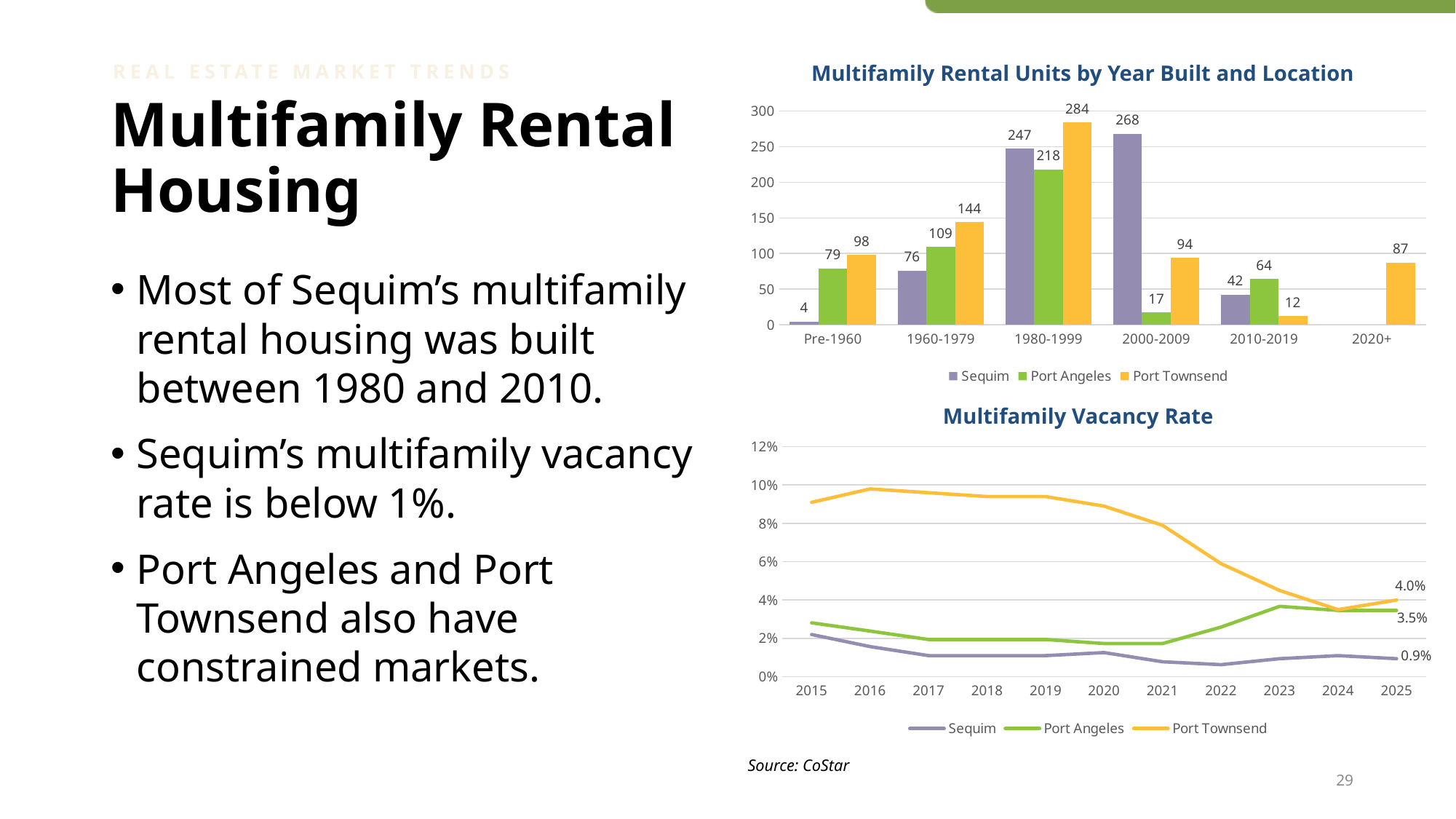
In the 'Multifamily Rental Units by Year Built and Location' chart, which period has the highest value for Sequim? 2000-2009 In the 'Multifamily Rental Units by Year Built and Location' chart, which is larger for 2010-2019: Sequim or Port Angeles? Port Angeles In the 'Multifamily Rental Units by Year Built and Location' chart, which period has the lowest value for Port Angeles? 2000-2009 In the 'Multifamily Vacancy Rate' chart, what is the Sequim vacancy rate in 2025? 0.9% In the 'Multifamily Rental Units by Year Built and Location' chart, how many Sequim units were built in 2000-2009? 268 In the 'Multifamily Rental Units by Year Built and Location' chart, how many series does the legend list? 3 In the 'Multifamily Rental Units by Year Built and Location' chart, how many Port Townsend units were built in 1980-1999? 284 In the 'Multifamily Vacancy Rate' chart, is the Port Townsend value for 2016 greater or less than 8%? greater In the 'Multifamily Rental Units by Year Built and Location' chart, how many year-built categories are shown on the x axis? 6 In the 'Multifamily Rental Units by Year Built and Location' chart, what is the difference between Port Townsend and Port Angeles units built in 1960-1979? 35 What kind of chart is 'Multifamily Rental Units by Year Built and Location'? Bar chart In the 'Multifamily Vacancy Rate' chart, does the Port Townsend vacancy rate rise or fall from 2016 to 2024? Fall